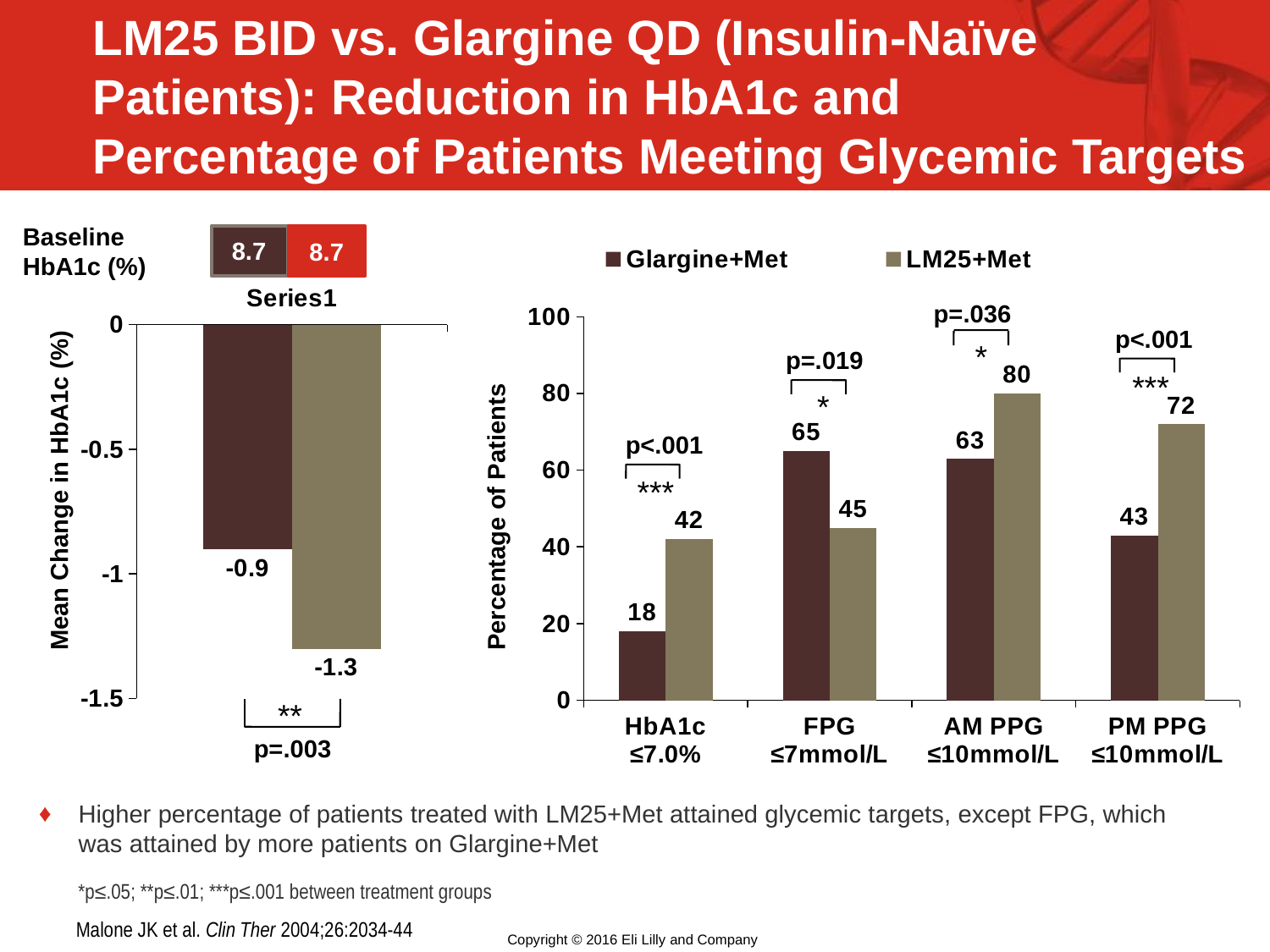
In the left-hand chart (Mean Change in HbA1c), what is the mean change in HbA1c for the LM25+Met bar? -1.3 How many series does the legend list for the bar charts? 2 In the right-hand chart (Percentage of Patients), which series has the larger value in the FPG ≤7mmol/L category? Glargine+Met In the right-hand chart (Percentage of Patients), what percentage of Glargine+Met patients met the HbA1c ≤7.0% target? 18 How many categories are shown on the x axis of the right-hand chart (Percentage of Patients)? 4 In the left-hand chart (Mean Change in HbA1c), what is the difference between the Glargine+Met change (-0.9) and the LM25+Met change (-1.3)? 0.4 In the right-hand chart (Percentage of Patients), which category has the highest LM25+Met value? AM PPG ≤10mmol/L In the right-hand chart (Percentage of Patients), what is the difference between the LM25+Met and Glargine+Met values for PM PPG ≤10mmol/L? 29 In the right-hand chart (Percentage of Patients), what is the value for LM25+Met in the FPG ≤7mmol/L category? 45 What type of chart is the right-hand chart (Percentage of Patients)? Bar chart In the right-hand chart (Percentage of Patients), what percentage of LM25+Met patients met the AM PPG ≤10mmol/L target? 80 In the right-hand chart (Percentage of Patients), which category has the lowest Glargine+Met value? HbA1c ≤7.0%